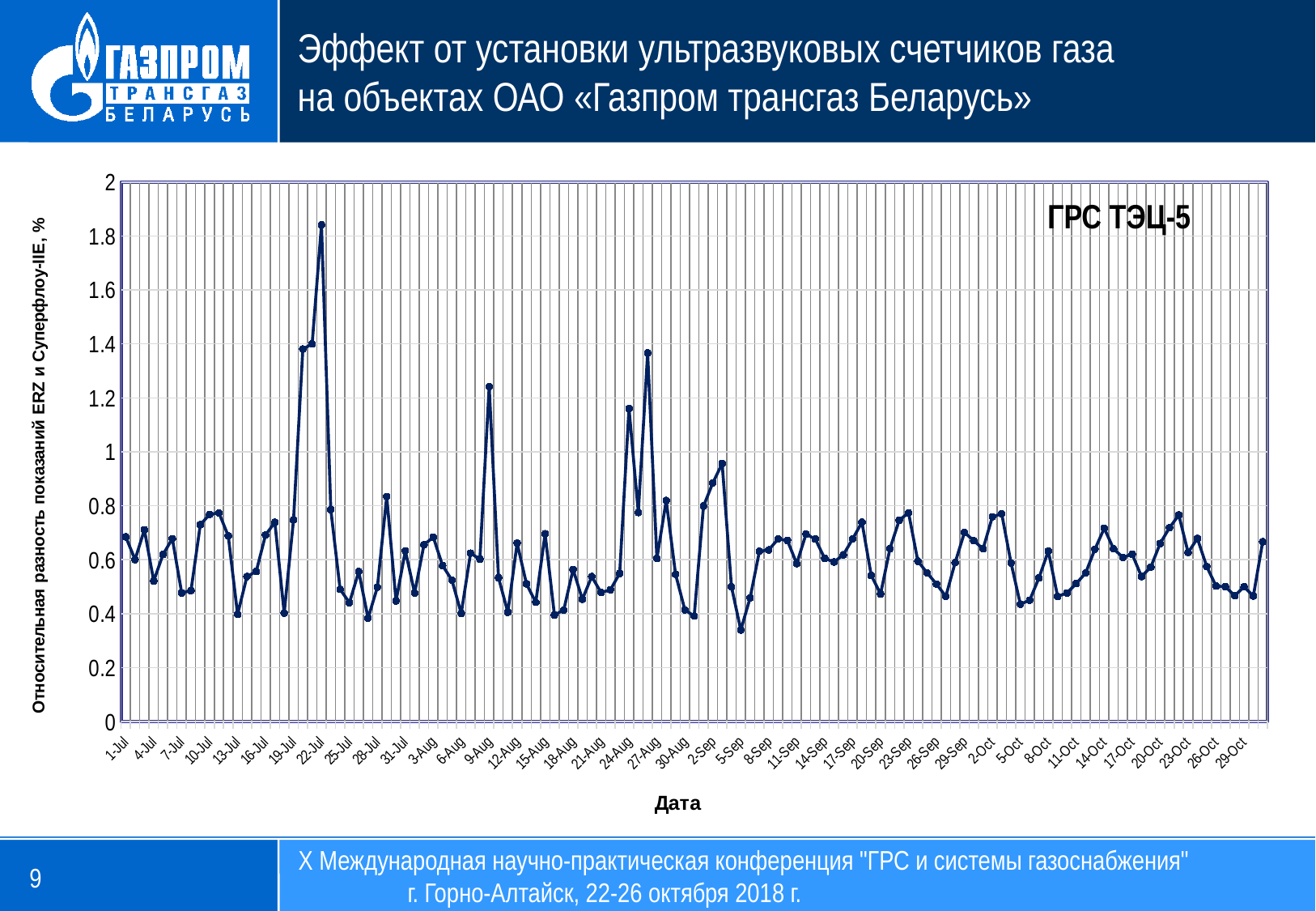
What is the title shown inside the chart? ГРС ТЭЦ-5 Which is larger, the value for 27-Aug or the value for 5-Sep? 27-Aug Is the value for 1-Jul greater or less than 0.8? less Is the value for 27-Aug greater or less than 1.2? less What is the x-axis title of the chart? Дата Is the value for 22-Jul greater or less than 1.6? greater Which is larger, the value for 22-Jul or the value for 9-Aug? 22-Jul What kind of chart is shown on the slide? line chart On which date does the chart reach its highest value? 22-Jul